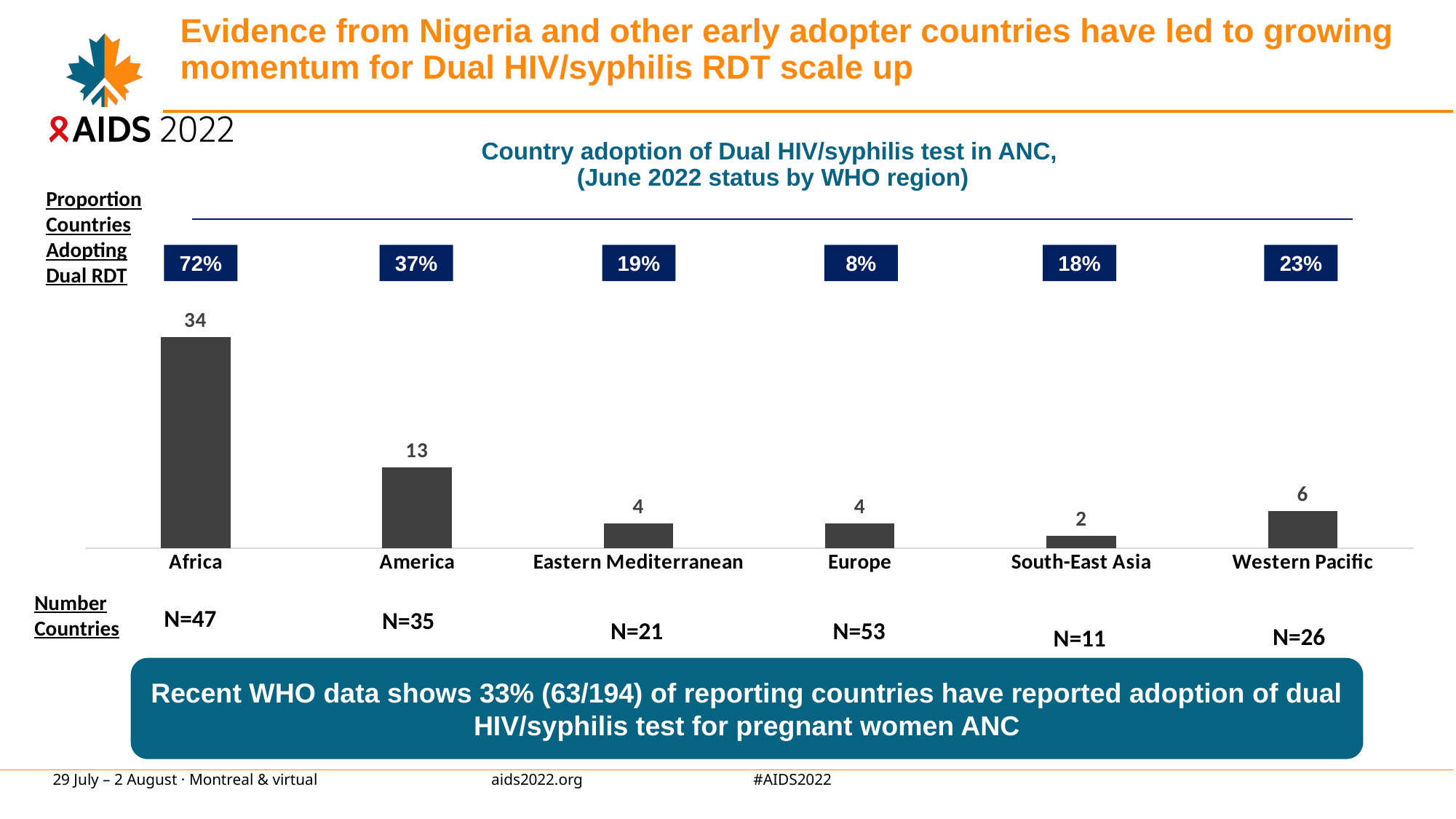
What is the value of the bar for America? 13 What is the number of countries (N) shown for Europe? N=53 What is the difference between the bar values for Africa and America? 21 What proportion of countries adopting Dual RDT is shown above the Africa bar? 72% Which has a larger bar value, Western Pacific or Europe? Western Pacific Which region has the highest bar? Africa How many regions are shown on the x axis of the chart? 6 What is the value of the bar for Africa? 34 Which region has the lowest bar? South-East Asia What is the value of the bar for Western Pacific? 6 What is the title of the chart? Country adoption of Dual HIV/syphilis test in ANC, (June 2022 status by WHO region) What kind of chart is shown on the slide? bar chart